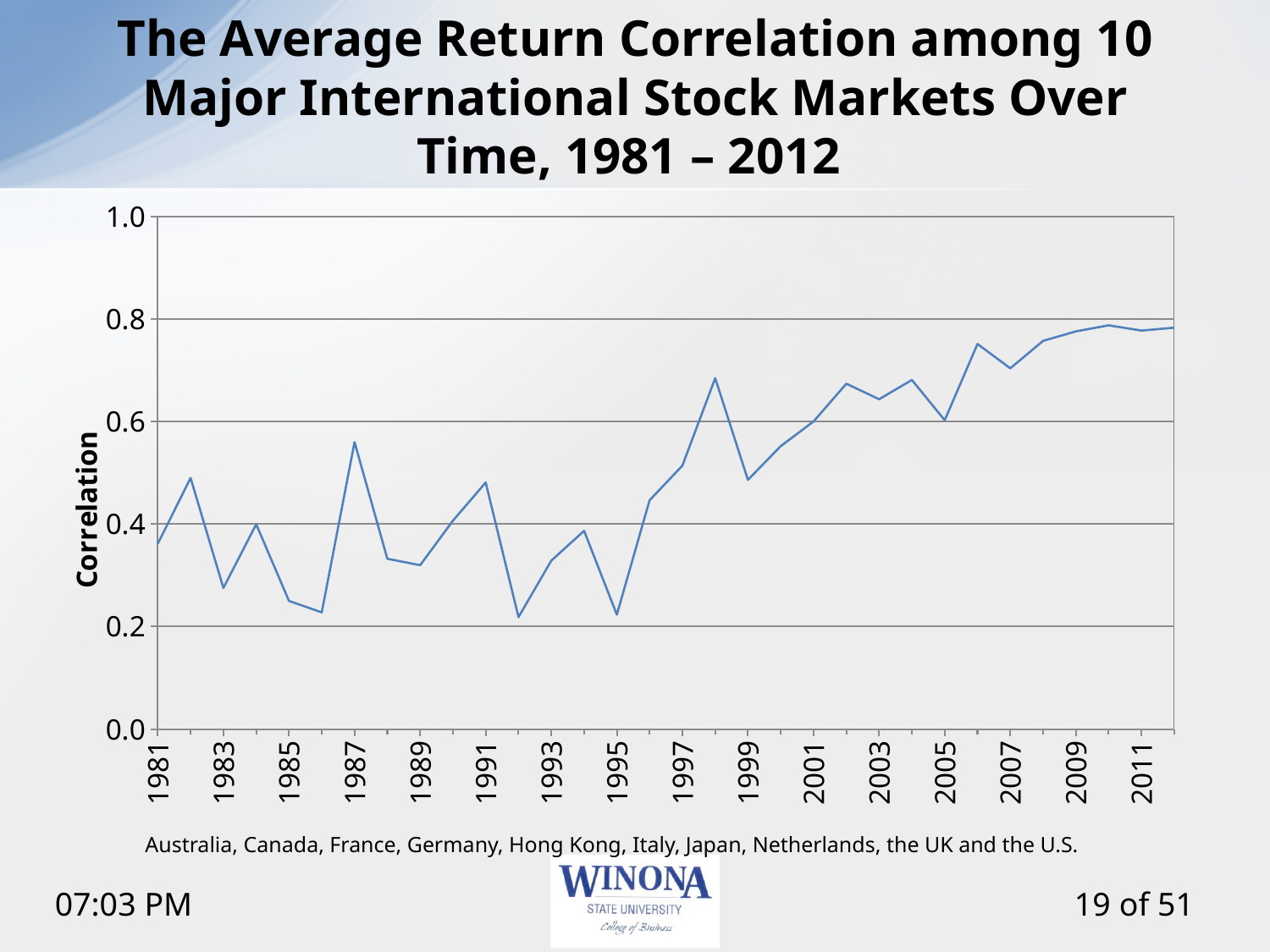
What is the label on the vertical axis of the chart? Correlation Overall, do the correlation values rise or fall from 1981 to 2012? rise Is the correlation value for 2012 greater or less than 0.8? less What kind of chart is shown on the slide? line chart Which year has the higher correlation value, 1981 or 2011? 2011 Is the correlation value for 1981 greater or less than 0.4? less Is the correlation value for 1998 greater or less than 0.6? greater Which year has the higher correlation value, 1985 or 1987? 1987 What is the highest value shown on the vertical axis of the chart? 1.0